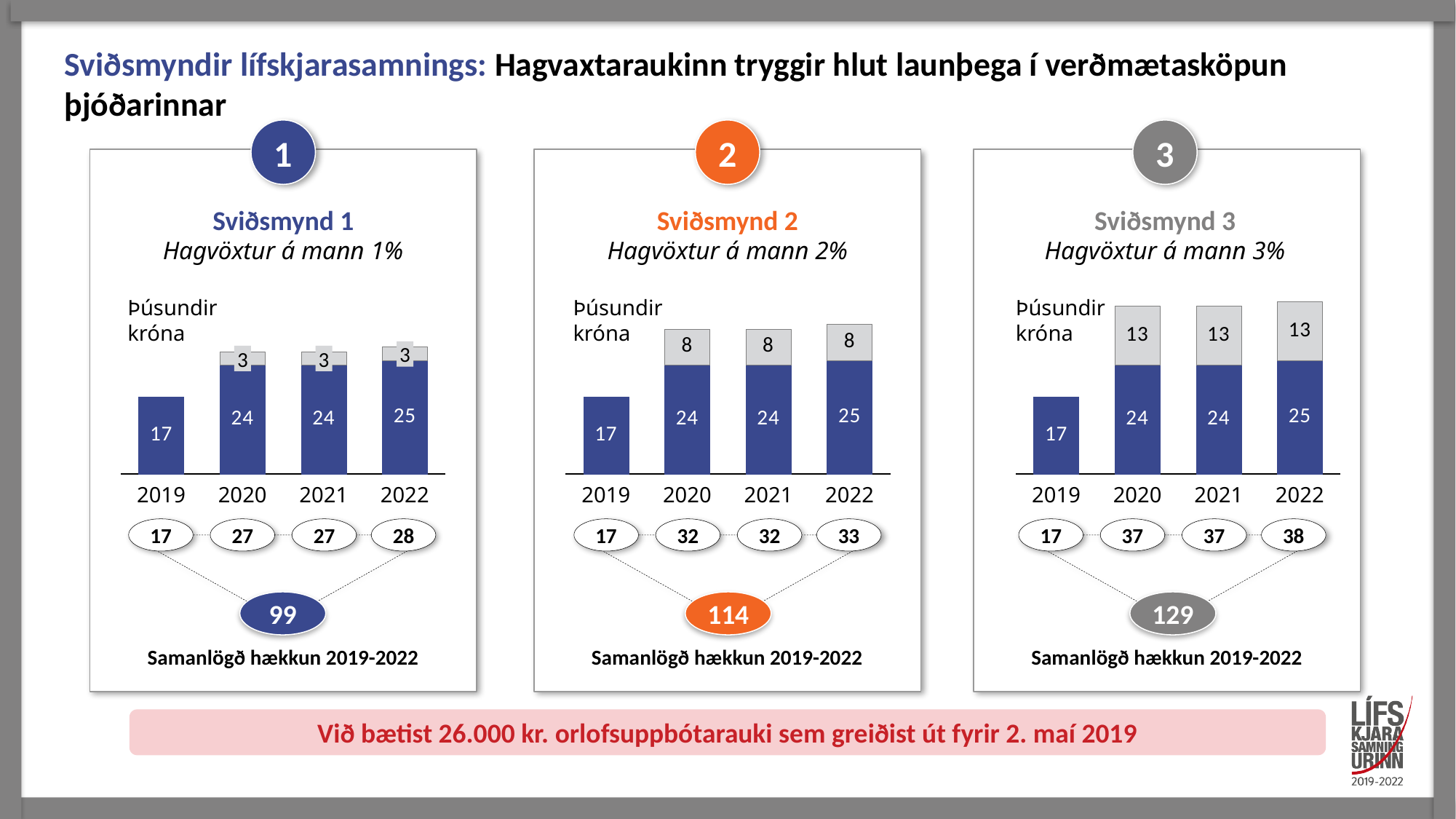
What kind of chart is used in the Sviðsmynd 3 panel? Stacked bar chart In the Sviðsmynd 1 chart, what is the value of the grey segment for 2022? 3 In the Sviðsmynd 2 chart, what is the total of the stacked bar for 2020? 32 In the Sviðsmynd 3 chart, what is the difference between the blue segment for 2022 and the blue segment for 2019? 8 In the Sviðsmynd 1 chart, what is the total of the stacked bar for 2022? 28 In the Sviðsmynd 2 chart, what is the value of the grey segment for 2021? 8 In the Sviðsmynd 2 chart, is the grey segment for 2022 larger or smaller than the grey segment for 2022 in the Sviðsmynd 3 chart? Smaller In the Sviðsmynd 1 chart, what is the value of the blue segment for 2019? 17 In the Sviðsmynd 3 chart, what is the total of the stacked bar for 2022? 38 In the Sviðsmynd 3 chart, what is the value of the grey segment for 2020? 13 How many years are shown on the x axis of the Sviðsmynd 1 chart? 4 In the Sviðsmynd 2 chart, which year has the lowest total bar? 2019